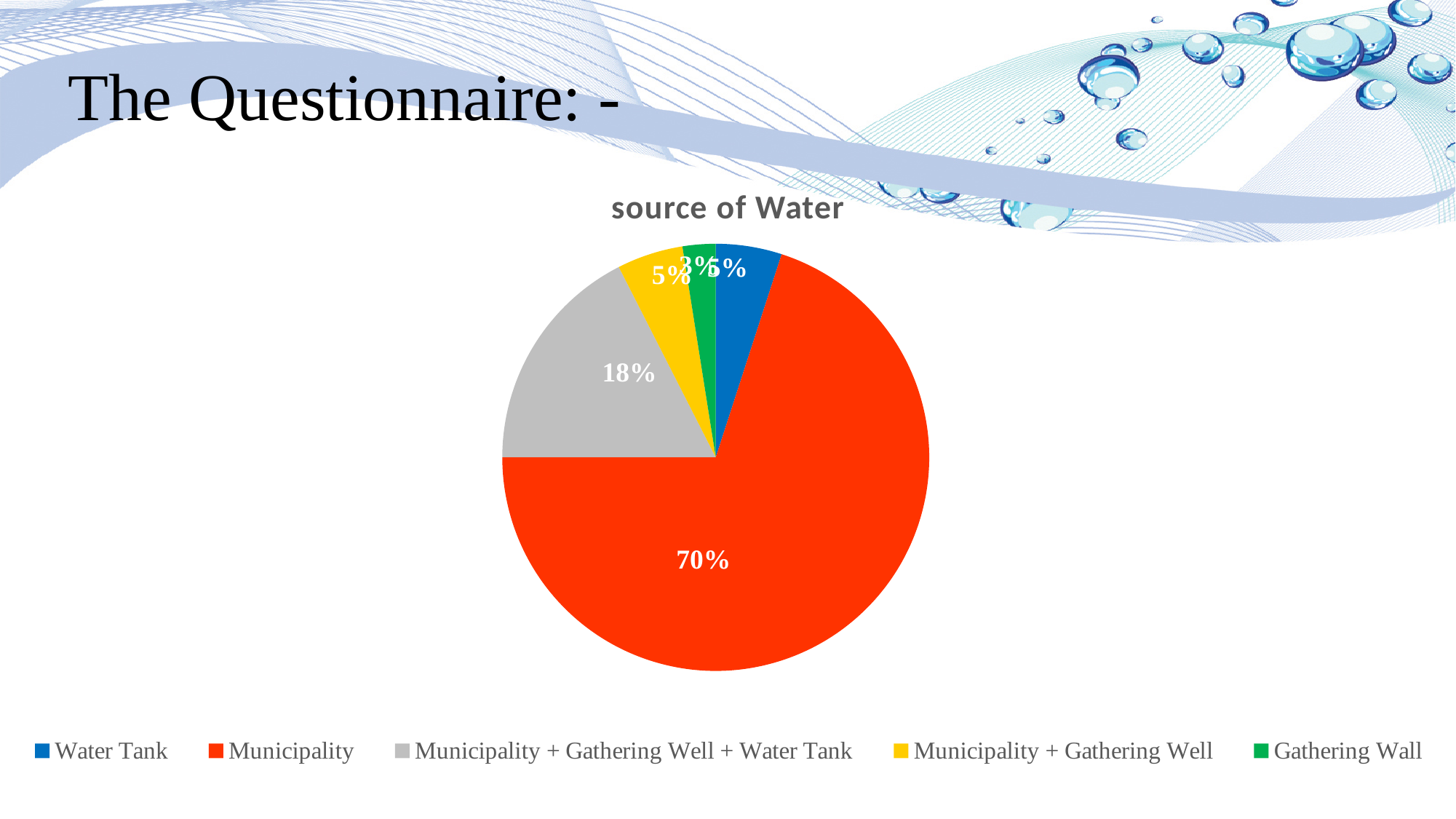
What colour is the Municipality slice in the pie chart? red How many slices does the pie chart have? 5 What share of the pie does Municipality + Gathering Well + Water Tank have? 18% What share of the pie does Municipality have? 70% What is the title of the chart? source of Water What share of the pie does Water Tank have? 5% Which source of water has the smallest slice of the pie? Gathering Wall What kind of chart is shown on the slide? pie chart Which is larger: the Municipality + Gathering Well + Water Tank slice or the Water Tank slice? Municipality + Gathering Well + Water Tank What share of the pie does Municipality + Gathering Well have? 5% Which source of water has the largest slice of the pie? Municipality How many percentage points larger is the Municipality slice than the Municipality + Gathering Well + Water Tank slice? 52%